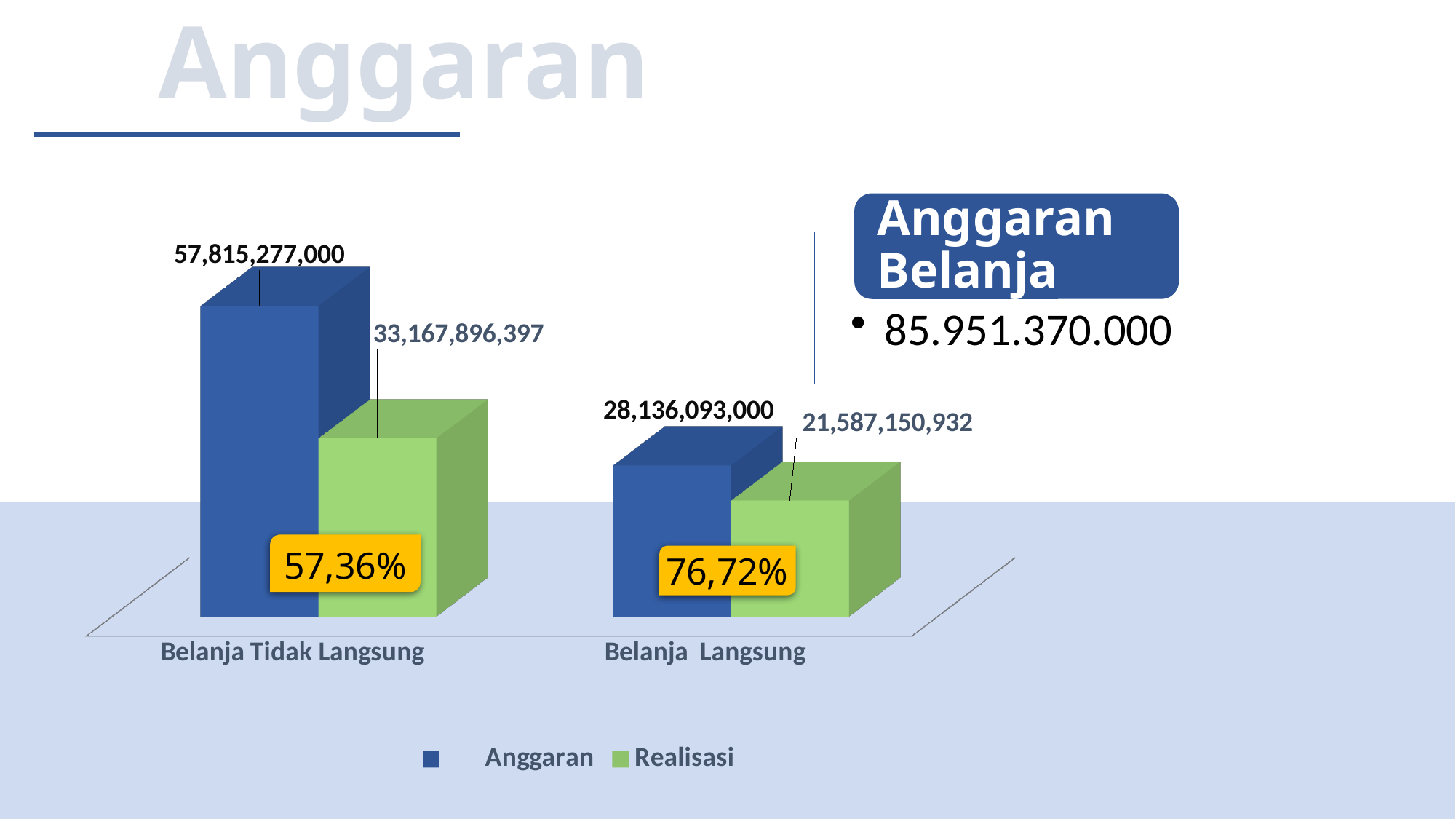
What is the difference between Anggaran and Realisasi for Belanja Langsung? 6,548,942,068 Which is larger: the Realisasi for Belanja Tidak Langsung or the Anggaran for Belanja Langsung? Realisasi for Belanja Tidak Langsung What is the Realisasi value for Belanja Langsung? 21,587,150,932 What is the Anggaran value for Belanja Langsung? 28,136,093,000 What percentage is shown on the chart for Belanja Tidak Langsung? 57,36% Which category has the highest Anggaran value? Belanja Tidak Langsung What percentage is shown on the chart for Belanja Langsung? 76,72% Which category has the lowest Realisasi value? Belanja Langsung What is the difference between Anggaran and Realisasi for Belanja Tidak Langsung? 24,647,380,603 What is the Anggaran value for Belanja Tidak Langsung? 57,815,277,000 How many series does the legend list? 2 What is the Realisasi value for Belanja Tidak Langsung? 33,167,896,397